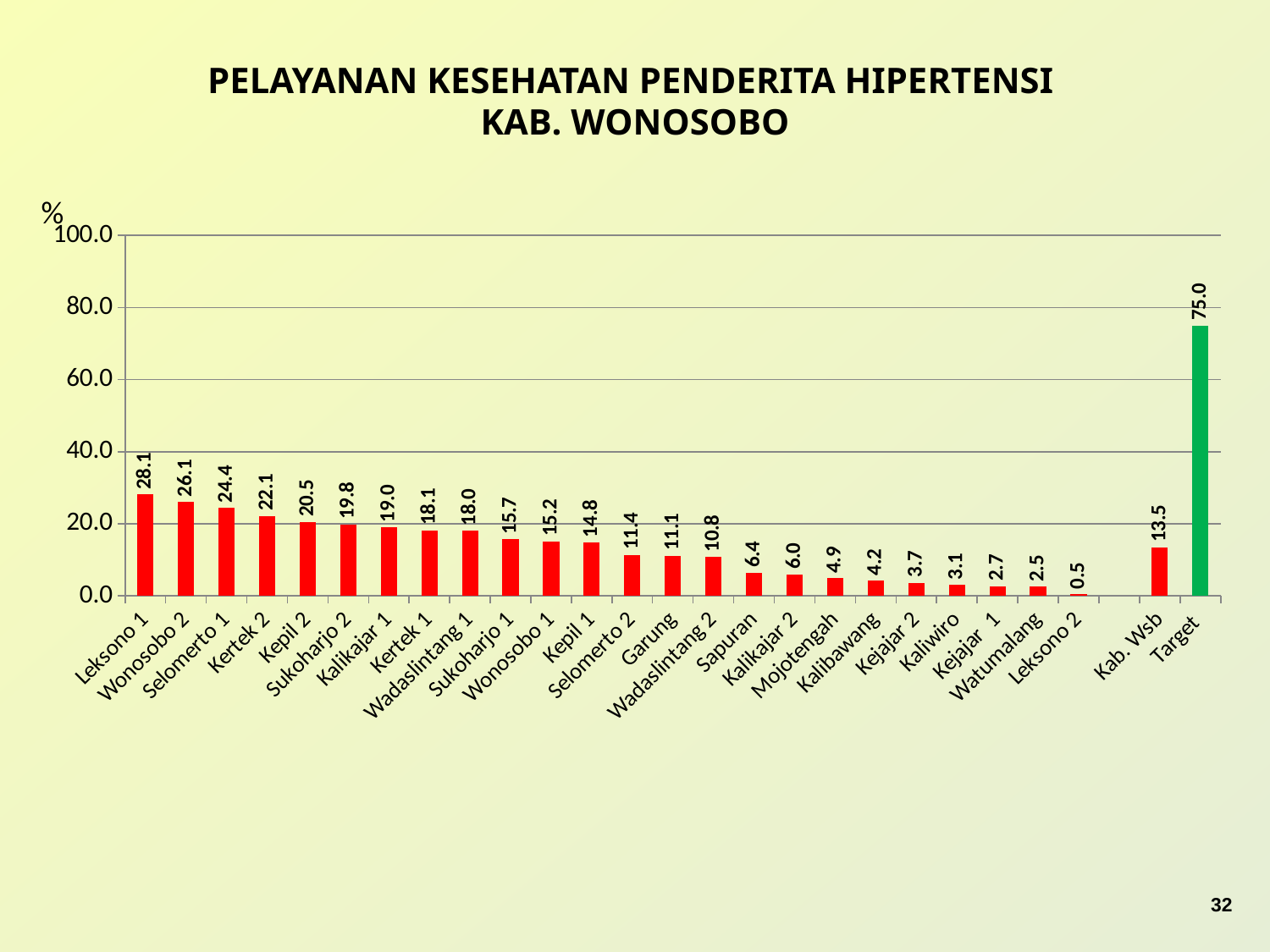
Which is larger, the value for Sapuran or the value for Mojotengah? Sapuran What is the value for Garung? 11.1 What is the difference between Leksono 1 and Wonosobo 2? 2.0 What is the value for Kab. Wsb? 13.5 Which category has the lowest value? Leksono 2 What is the value for Target? 75.0 What is the difference between the Target value and the Kab. Wsb value? 61.5 Which category has the highest value? Target How many categories are shown on the x axis? 26 Is the value for Target greater or less than 60.0? greater What is the value for Leksono 1? 28.1 What kind of chart is shown on the slide? Bar chart